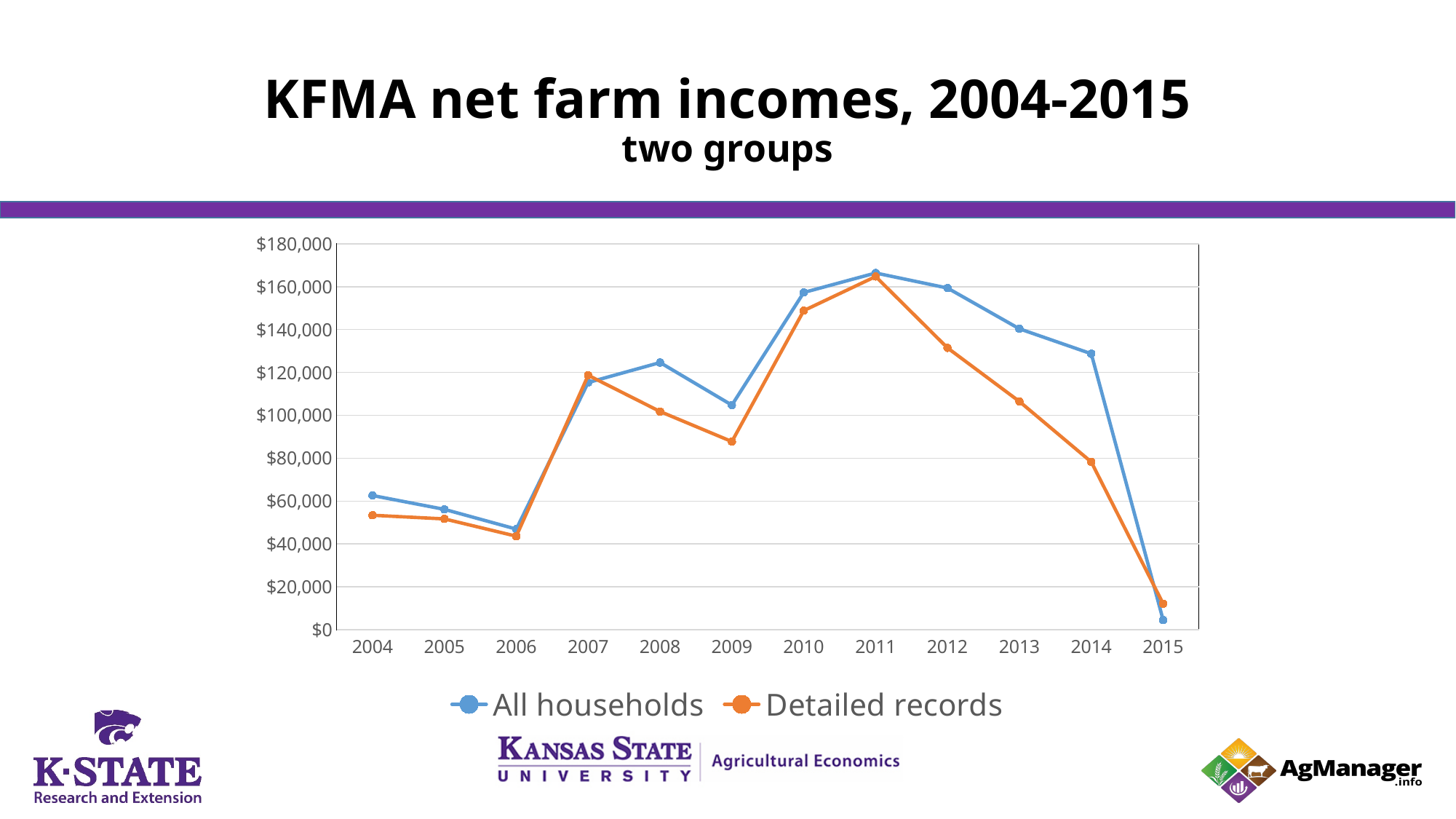
What is the title of the chart on the slide? KFMA net farm incomes, 2004-2015 What kind of chart is shown on the slide? line chart Is the All households value for 2010 greater or less than $140,000? greater Do the Detailed records values rise or fall from 2011 to 2015? fall In which year does the Detailed records series reach its lowest value? 2015 Is the All households value for 2015 greater or less than $20,000? less How many years are plotted along the x axis? 12 Is the Detailed records value for 2014 greater or less than $100,000? less How many series does the legend list? 2 In which year does the All households series reach its highest value? 2011 In 2014, which series has the larger value, All households or Detailed records? All households Do the All households values rise or fall from 2004 to 2006? fall